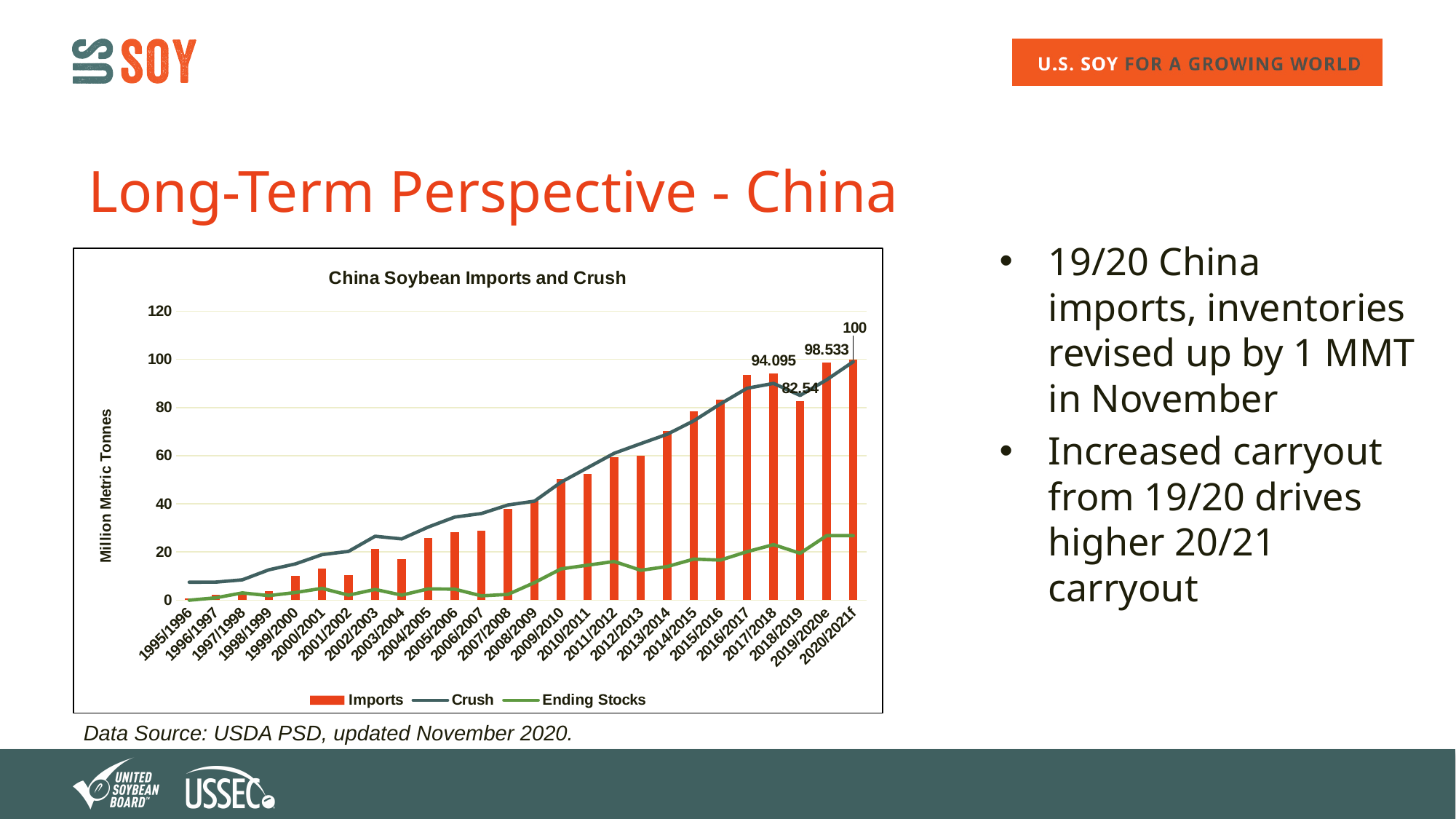
How many series does the chart legend list? 3 What is the Imports value for 2020/2021f? 100 What kind of chart is shown on the slide? Combined bar and line chart What is the Imports value for 2018/2019? 82.54 Which is larger, the Imports value for 2017/2018 or for 2018/2019? 2017/2018 What is the Imports value for 2019/2020e? 98.533 What is the Imports value for 2017/2018? 94.095 What is the title of the chart? China Soybean Imports and Crush What is the difference between the Imports values for 2019/2020e and 2018/2019? 15.993 Which year has the highest Imports value? 2020/2021f Is the Imports value for 2013/2014 greater or less than 60? greater Which year has the lowest Imports value? 1995/1996